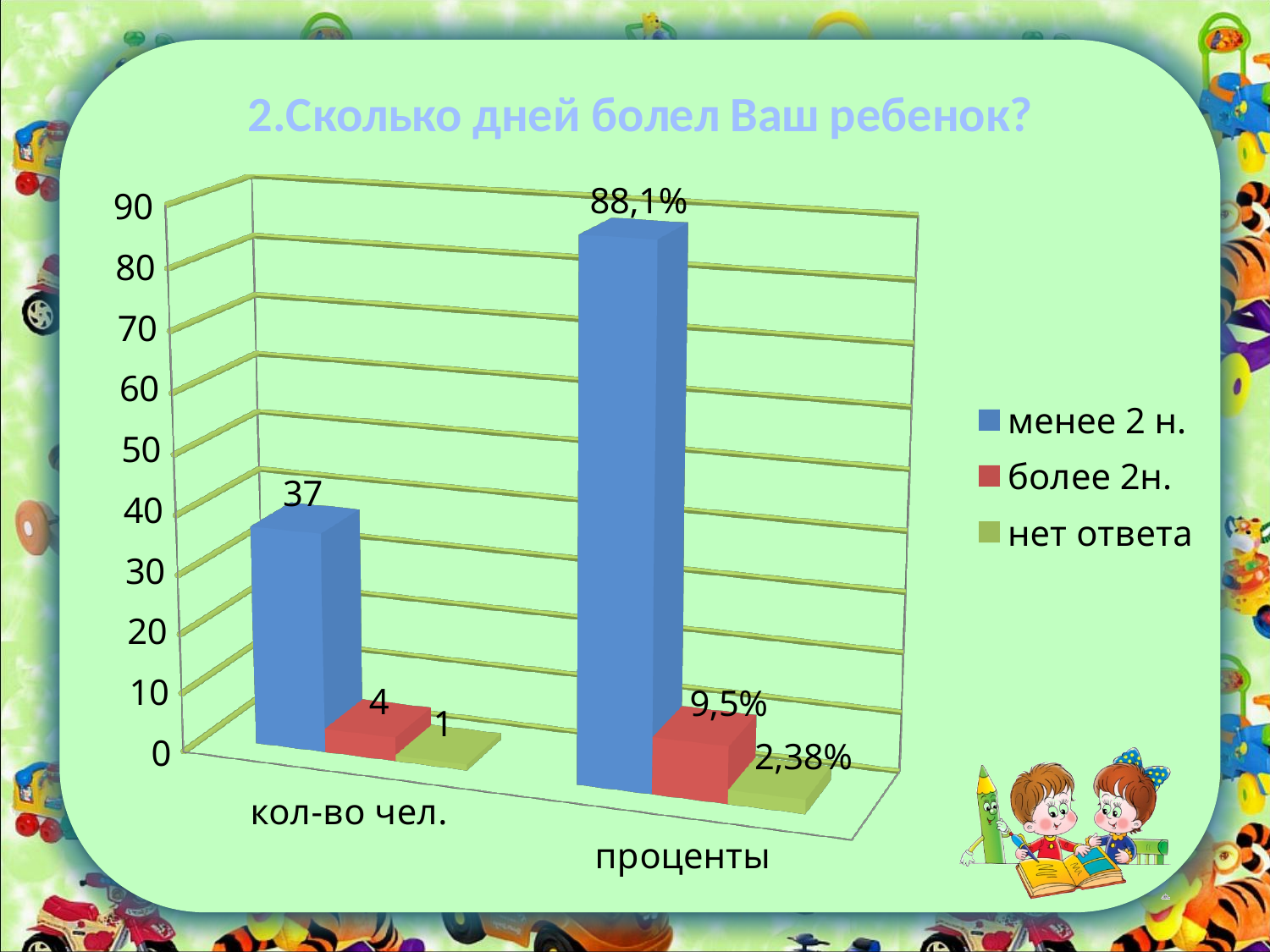
What kind of chart is shown on the slide? Bar chart What is the title of the chart? 2.Сколько дней болел Ваш ребенок? What is the difference between the "менее 2 н." and "более 2н." values in the "кол-во чел." category? 33 What is the value for "более 2н." in the "кол-во чел." category? 4 Which series has the lowest value in the "проценты" category? нет ответа How many series does the legend list? 3 What is the value for "менее 2 н." in the "кол-во чел." category? 37 Which series has the highest value in the "кол-во чел." category? менее 2 н. What is the value for "более 2н." in the "проценты" category? 9,5% What is the value for "менее 2 н." in the "проценты" category? 88,1% What is the value for "нет ответа" in the "кол-во чел." category? 1 What is the value for "нет ответа" in the "проценты" category? 2,38%